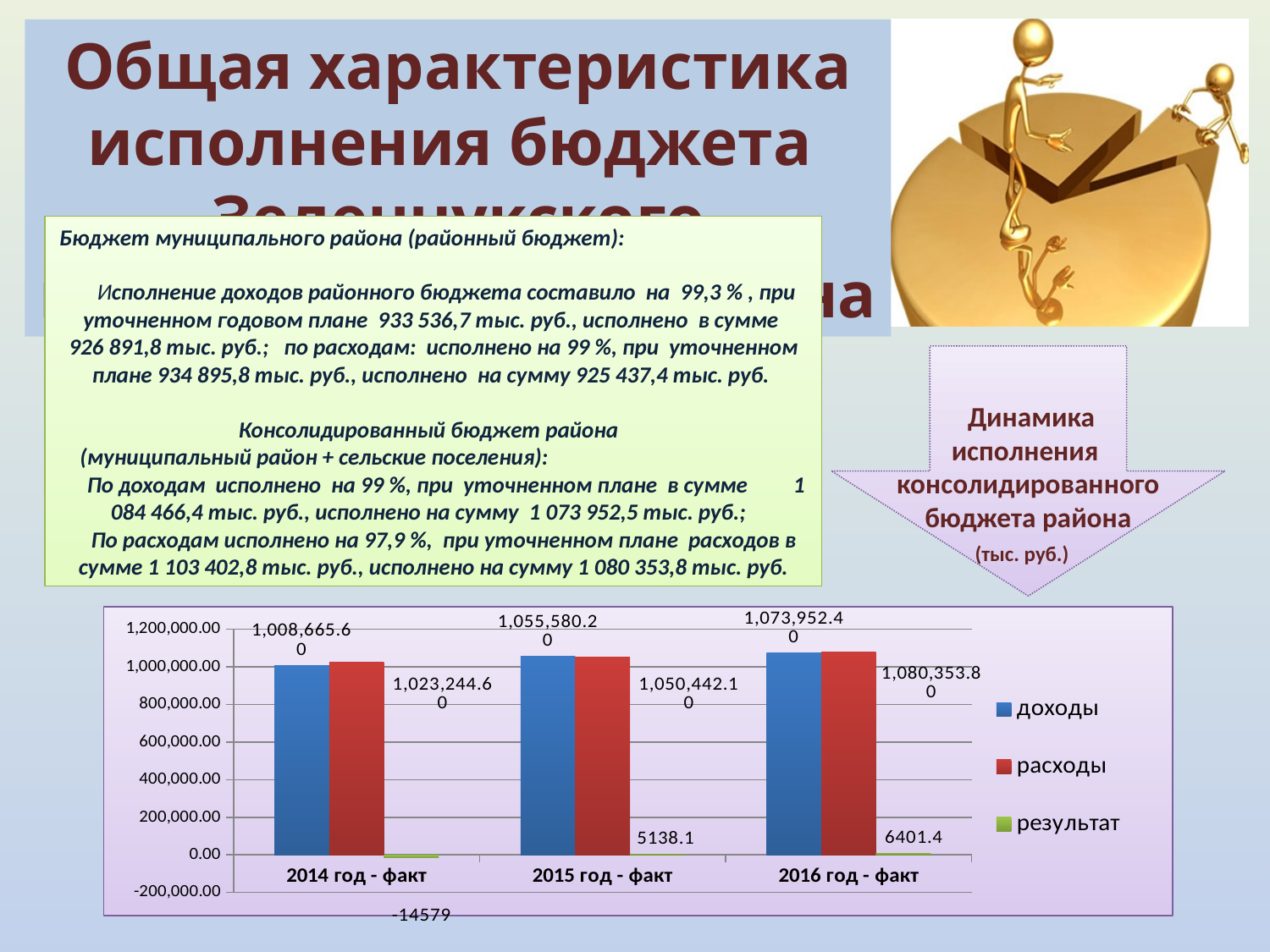
What kind of chart is shown on the slide? bar chart Do the доходы values rise or fall from 2014 to 2016? rise What is the value of результат for 2015 год - факт? 5138.1 In which year is результат the lowest? 2014 год - факт How many series does the chart legend list? 3 What is the difference between расходы and доходы for 2016 год - факт? 6,401.40 What is the value of расходы for 2016 год - факт? 1,080,353.80 What is the value of результат for 2014 год - факт? -14579 Which series is shown in red in the chart? расходы What is the value of доходы for 2014 год - факт? 1,008,665.60 In which year is доходы the highest? 2016 год - факт How many categories are shown on the x axis of the chart? 3